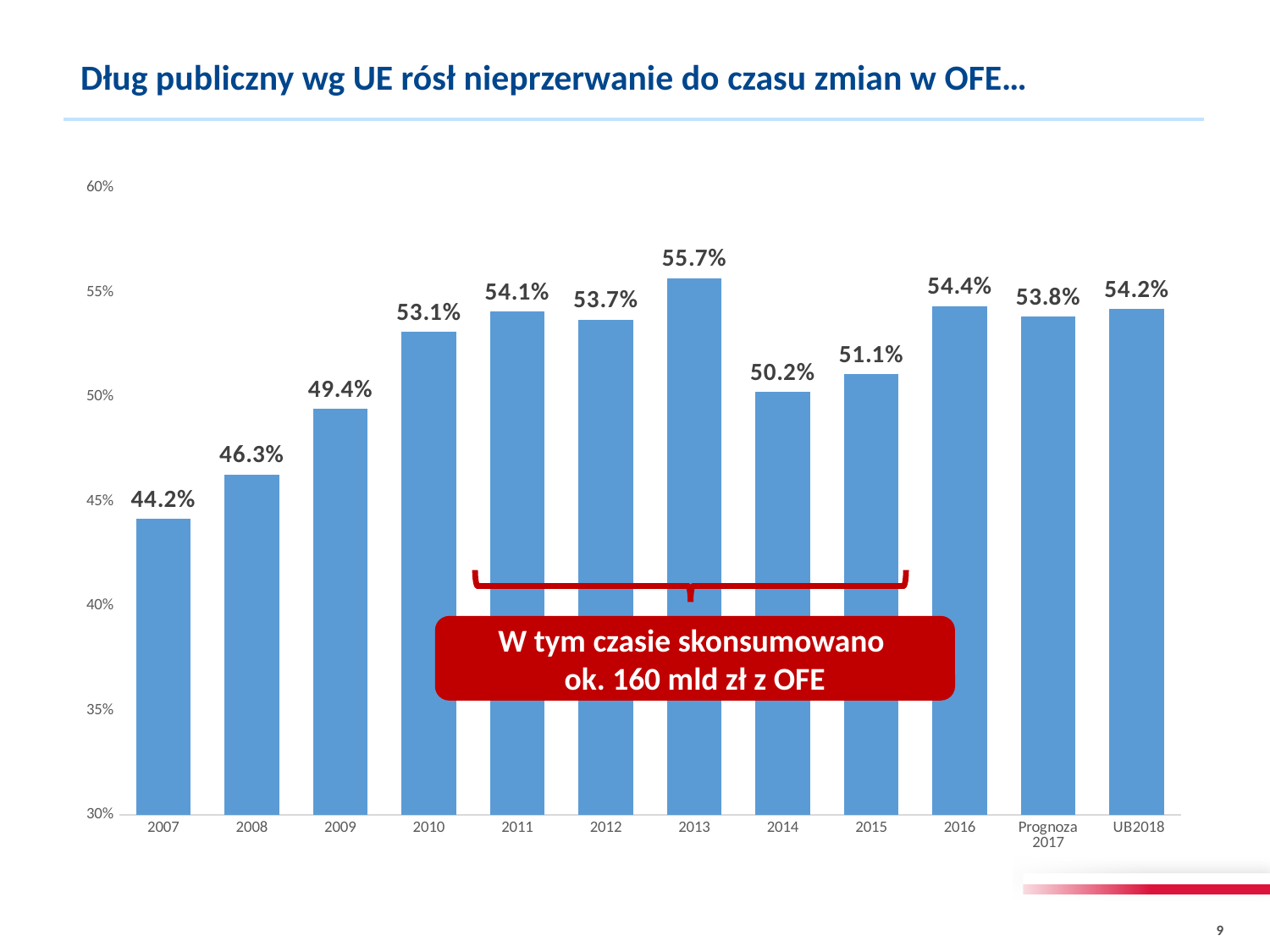
Do the values rise or fall from 2007 to 2013? rise What is the value for 2007? 44.2% What kind of chart is shown on the slide? bar chart How many categories are shown on the x axis? 12 What is the value for 2013? 55.7% What does the red callout box on the chart say? W tym czasie skonsumowano ok. 160 mld zł z OFE What is the value for Prognoza 2017? 53.8% Which is larger, the value for 2016 or the value for UB2018? 2016 What is the difference between the values for 2013 and 2014? 5.5% Which year has the highest value? 2013 Which category has the lowest value? 2007 Is the value for 2009 greater or less than 50%? less